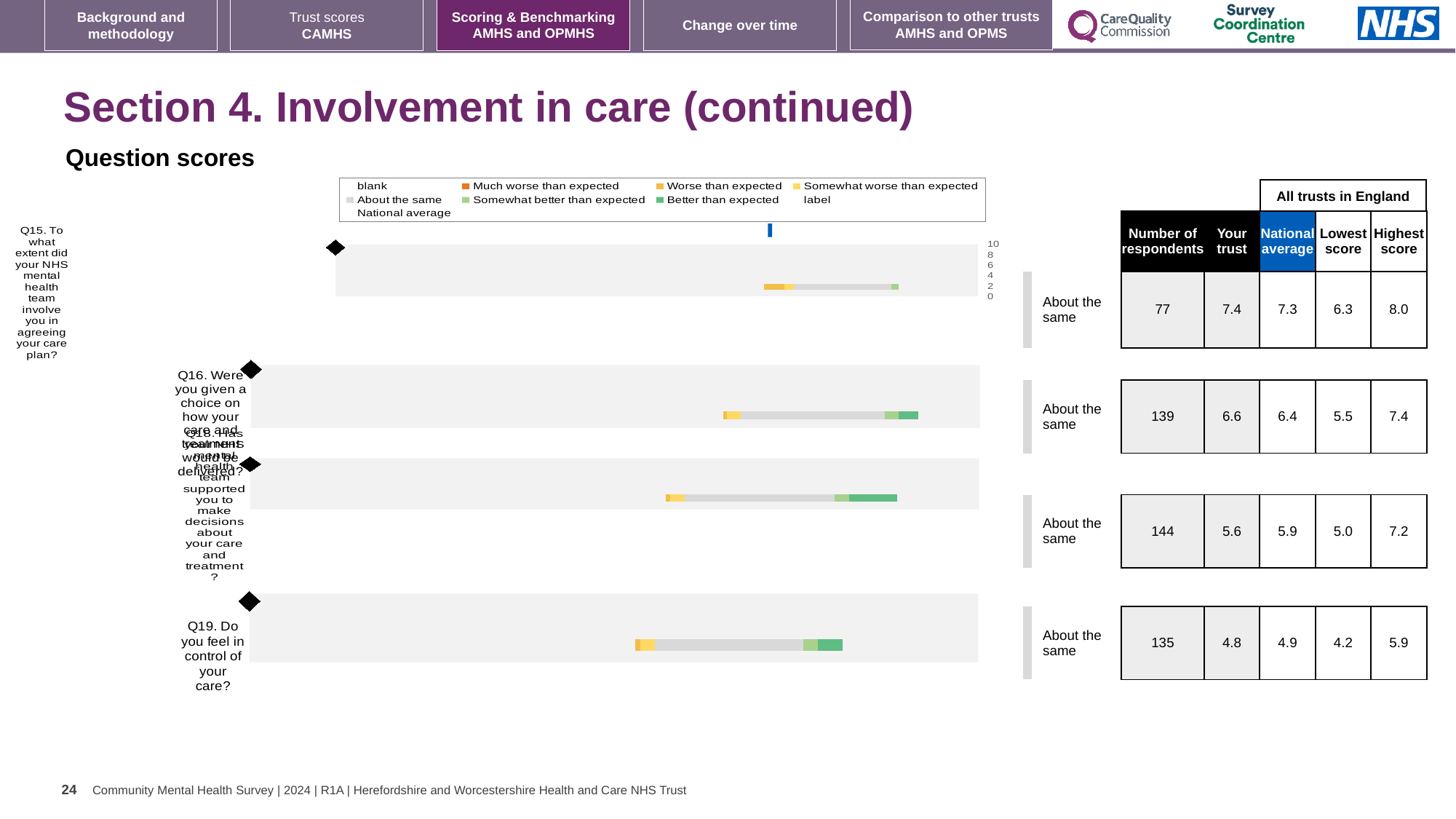
What benchmark category is shown for each of the four questions on this slide? About the same Which question has the lowest 'Your trust' score in the table? Q19 According to the table next to the chart, what is the 'Your trust' score for Q15 (involving you in agreeing your care plan)? 7.4 Which question has the highest 'Your trust' score in the table? Q15 For Q15, what is the difference between the highest score (8.0) and the lowest score (6.3) across all trusts in England? 1.7 According to the table, what is the highest score among all trusts in England for Q19 (feeling in control of your care)? 5.9 According to the table, what is the national average score for Q18 (supported to make decisions about care and treatment)? 5.9 How many questions (categories) are plotted in the question scores chart? 4 How many entries does the legend of the question scores chart list? 9 What kind of chart is used to show the question scores on this slide? bar chart According to the table, how many respondents answered Q16 (choice on how care and treatment would be delivered)? 139 For Q18, which is larger: the 'Your trust' score or the national average? National average